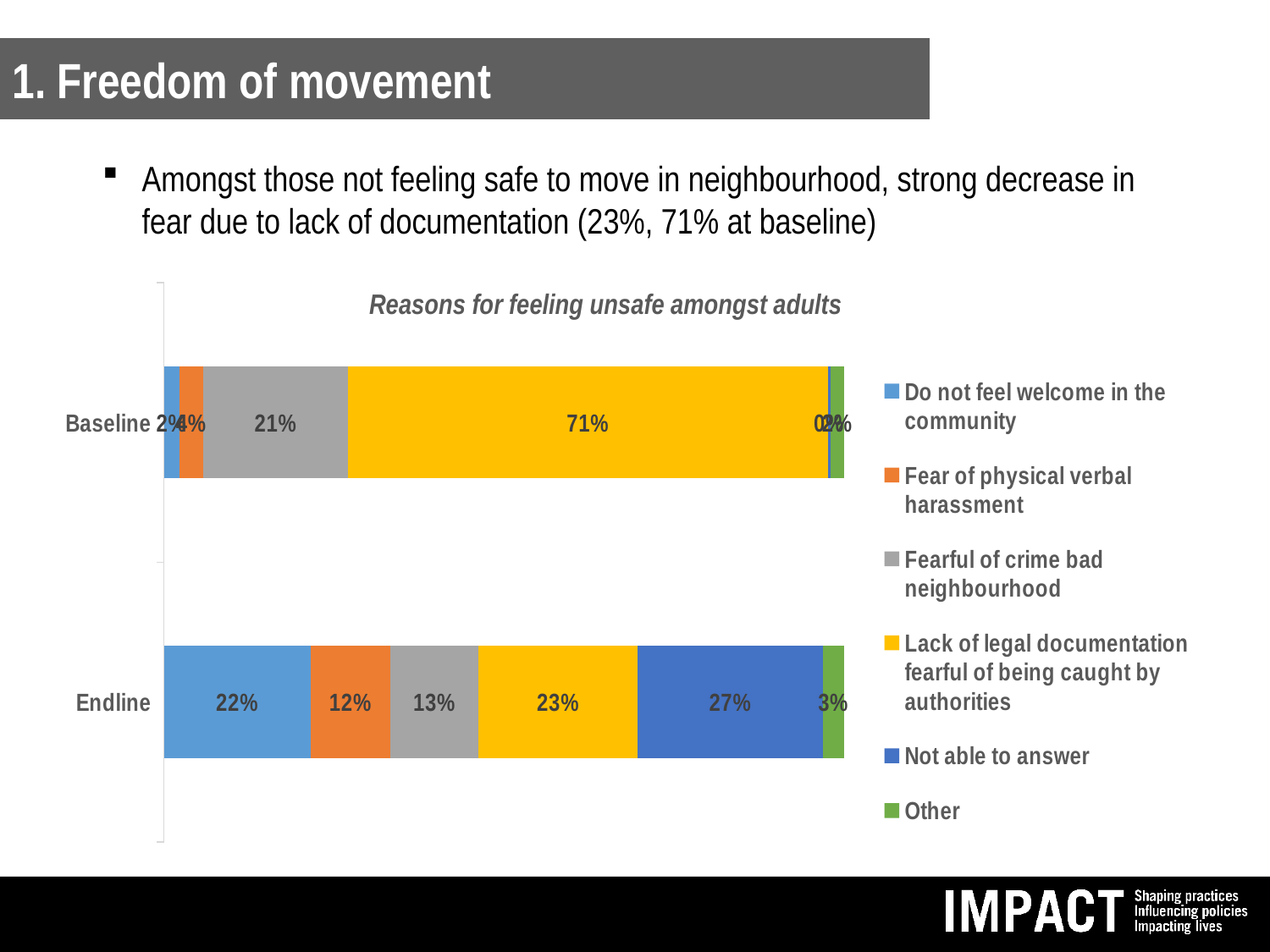
What kind of chart is shown on the slide? Stacked bar chart By how many percentage points did 'Lack of legal documentation fearful of being caught by authorities' fall from Baseline to Endline? 48 percentage points Which reason has the largest share in the Endline bar? Not able to answer In the Endline bar, which is larger: 'Do not feel welcome in the community' or 'Fear of physical verbal harassment'? Do not feel welcome in the community How many series does the legend of the chart list? 6 What is the Endline value for 'Lack of legal documentation fearful of being caught by authorities'? 23% What is the Baseline value for 'Fearful of crime bad neighbourhood'? 21% What is the Baseline value for 'Lack of legal documentation fearful of being caught by authorities'? 71% What is the Endline value for 'Not able to answer'? 27% What is the Endline value for 'Other'? 3% What is the title of the chart? Reasons for feeling unsafe amongst adults How many categories (bars) are plotted in the chart? 2